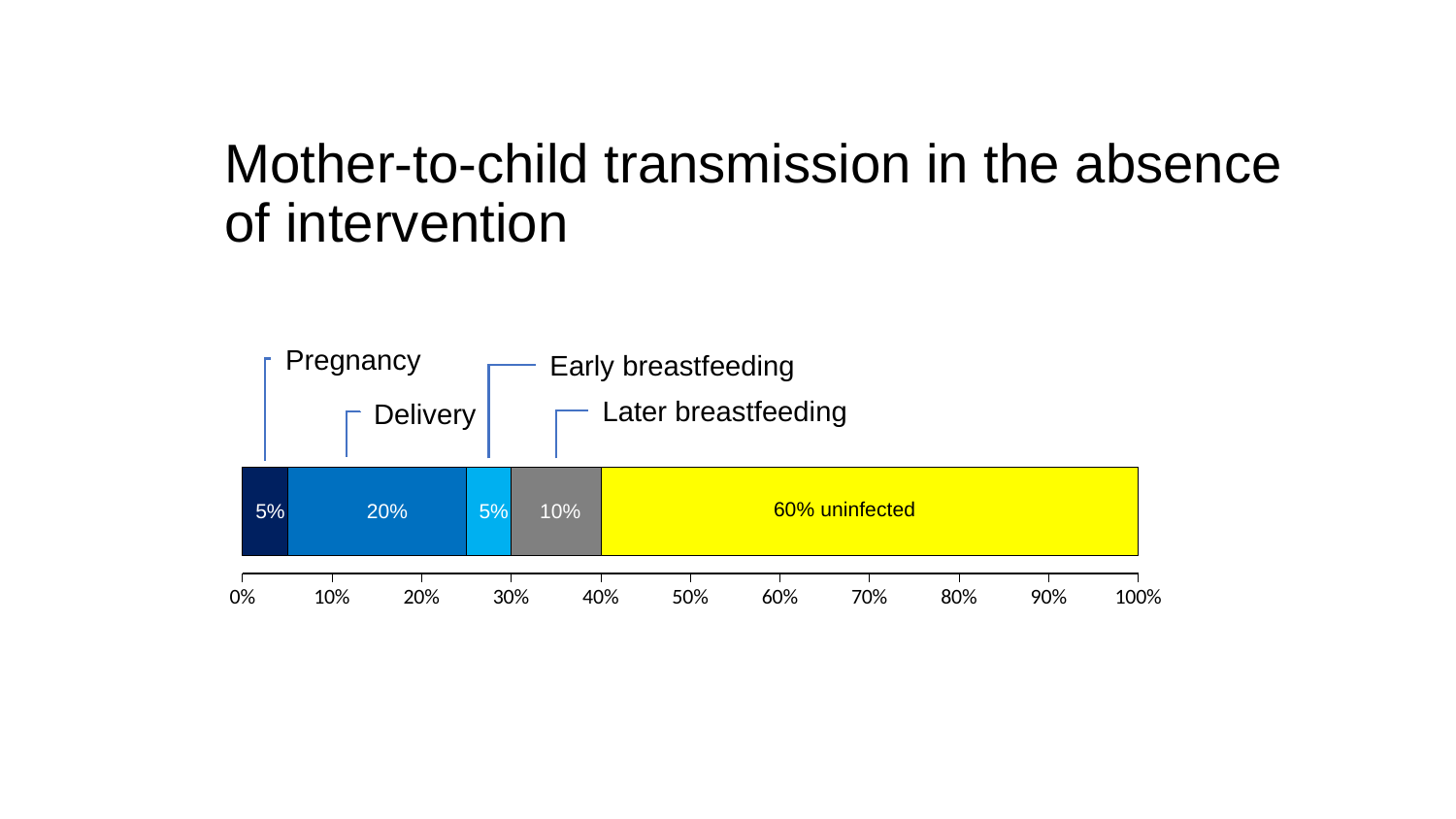
What percentage of mother-to-child transmission is attributed to pregnancy? 5% What kind of chart is shown on the slide? Stacked bar chart What is the difference between the delivery share and the later breastfeeding share? 10% What percentage of mother-to-child transmission is attributed to delivery? 20% What is the combined percentage of transmission across pregnancy, delivery, early breastfeeding and later breastfeeding? 40% Which transmission stage accounts for the largest share of infections? Delivery How many segments make up the stacked bar? 5 What is the title of the slide containing the chart? Mother-to-child transmission in the absence of intervention Which is larger, the share for delivery or the share for later breastfeeding? Delivery What percentage of children remain uninfected according to the chart? 60% What percentage is attributed to later breastfeeding? 10% What percentage is attributed to early breastfeeding? 5%